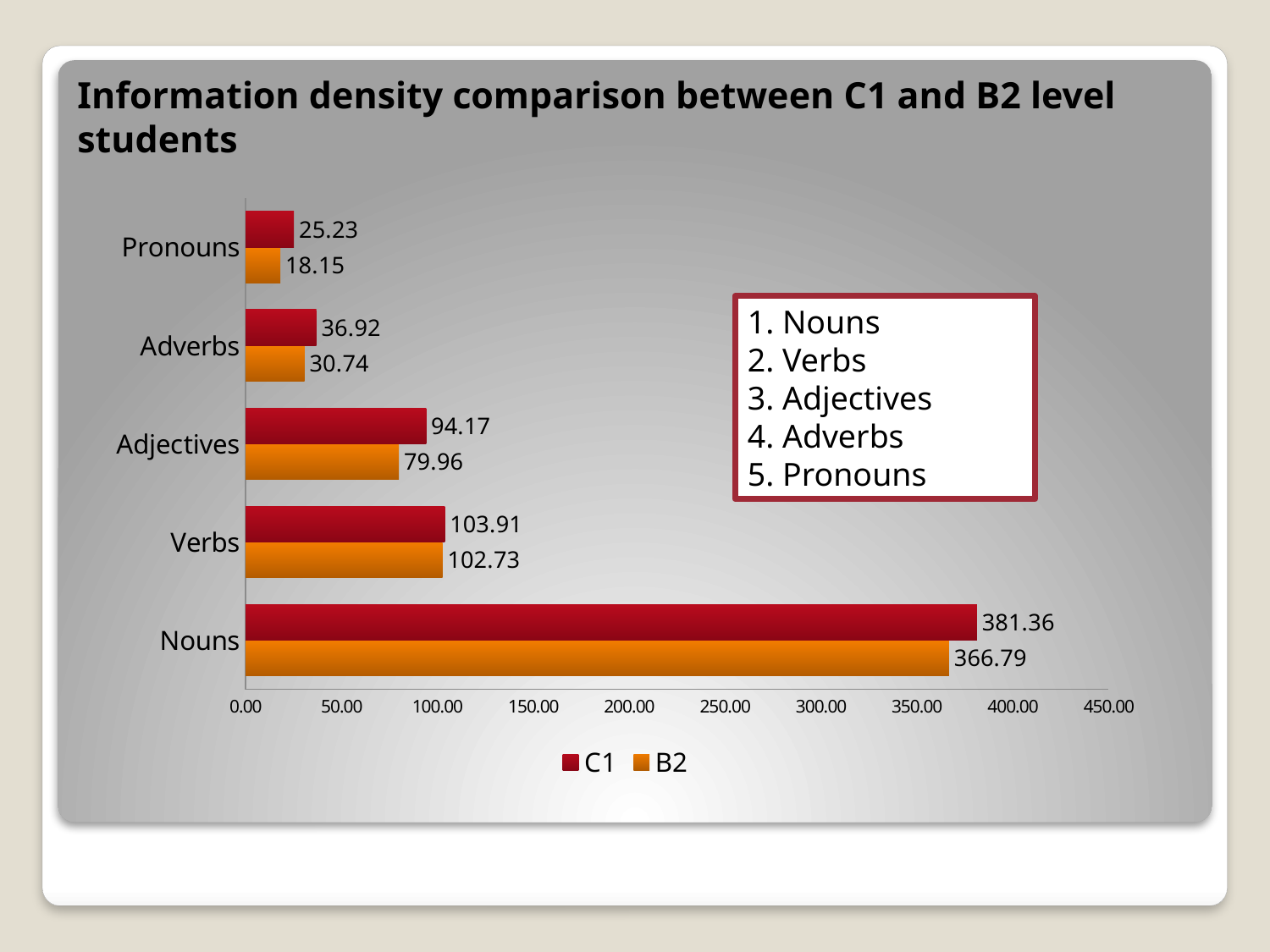
What is the B2 value for Pronouns? 18.15 What is the B2 value for Adjectives? 79.96 Which is larger for Adjectives, the C1 value or the B2 value? C1 Which category has the lowest B2 value? Pronouns Which colour represents the B2 series in the legend? Orange Which category has the highest C1 value? Nouns What is the difference between the C1 and B2 values for Nouns? 14.57 How many categories are shown on the chart? 5 What is the C1 value for Adverbs? 36.92 What kind of chart is shown on the slide? Bar chart How many series does the legend list? 2 What is the C1 value for Nouns? 381.36